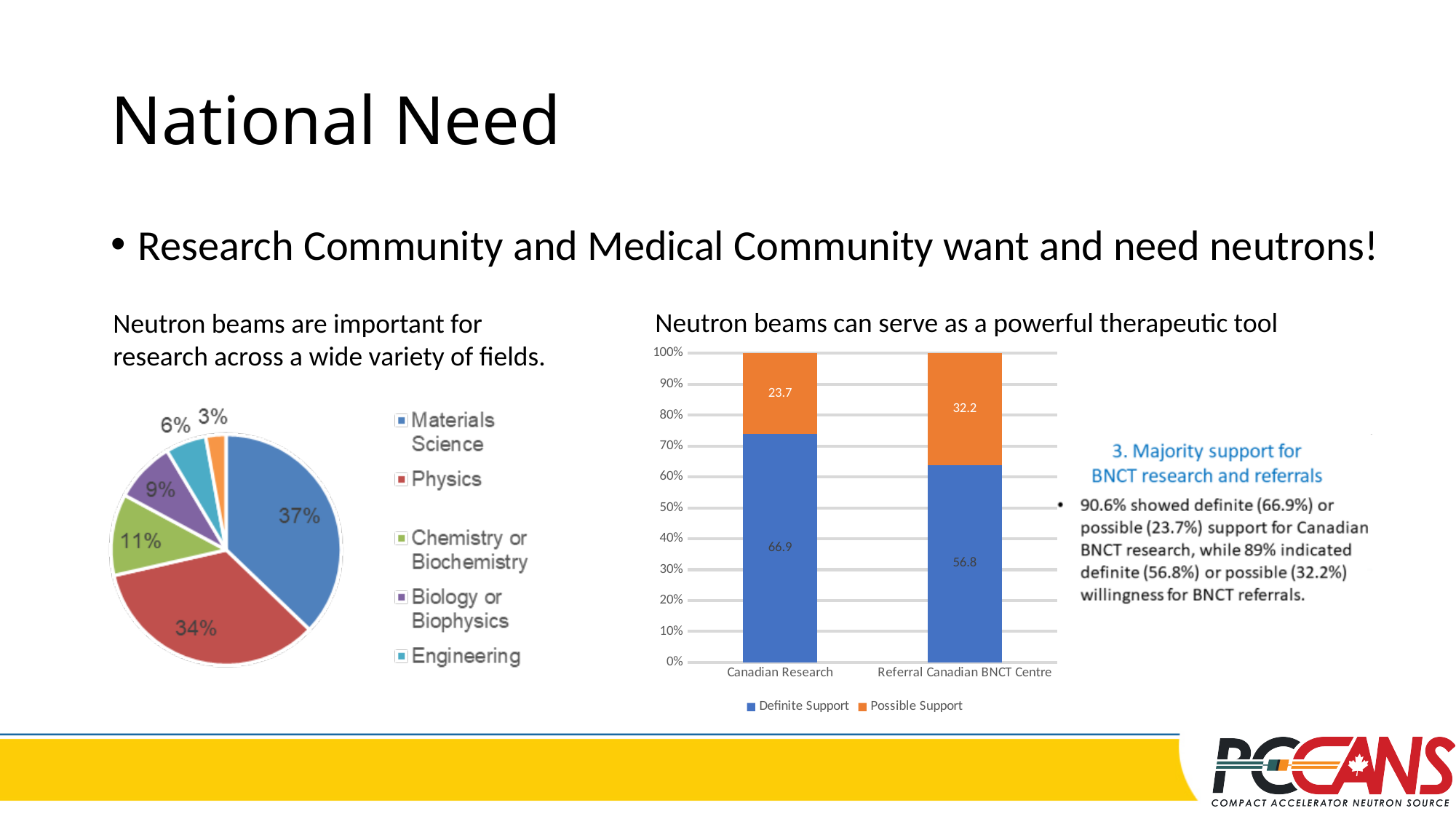
In the pie chart on the left, which field has the largest share? Materials Science In the bar chart on the right, which category has the higher Definite Support value? Canadian Research In the pie chart on the left, what share does Chemistry or Biochemistry have? 11% In the bar chart on the right, what is the Possible Support value for Referral Canadian BNCT Centre? 32.2 In the pie chart on the left, which is larger, the share for Biology or Biophysics or the share for Engineering? Biology or Biophysics In the pie chart on the left, what is the difference between the Materials Science share and the Physics share? 3% In the pie chart on the left, what share does Materials Science have? 37% In the pie chart on the left, what share does Physics have? 34% In the bar chart on the right, what is the Definite Support value for Canadian Research? 66.9 What type of chart is the chart on the left of the slide? Pie chart In the bar chart on the right, how many series does the legend list? 2 In the bar chart on the right, what is the total of the stacked bar for Canadian Research? 90.6